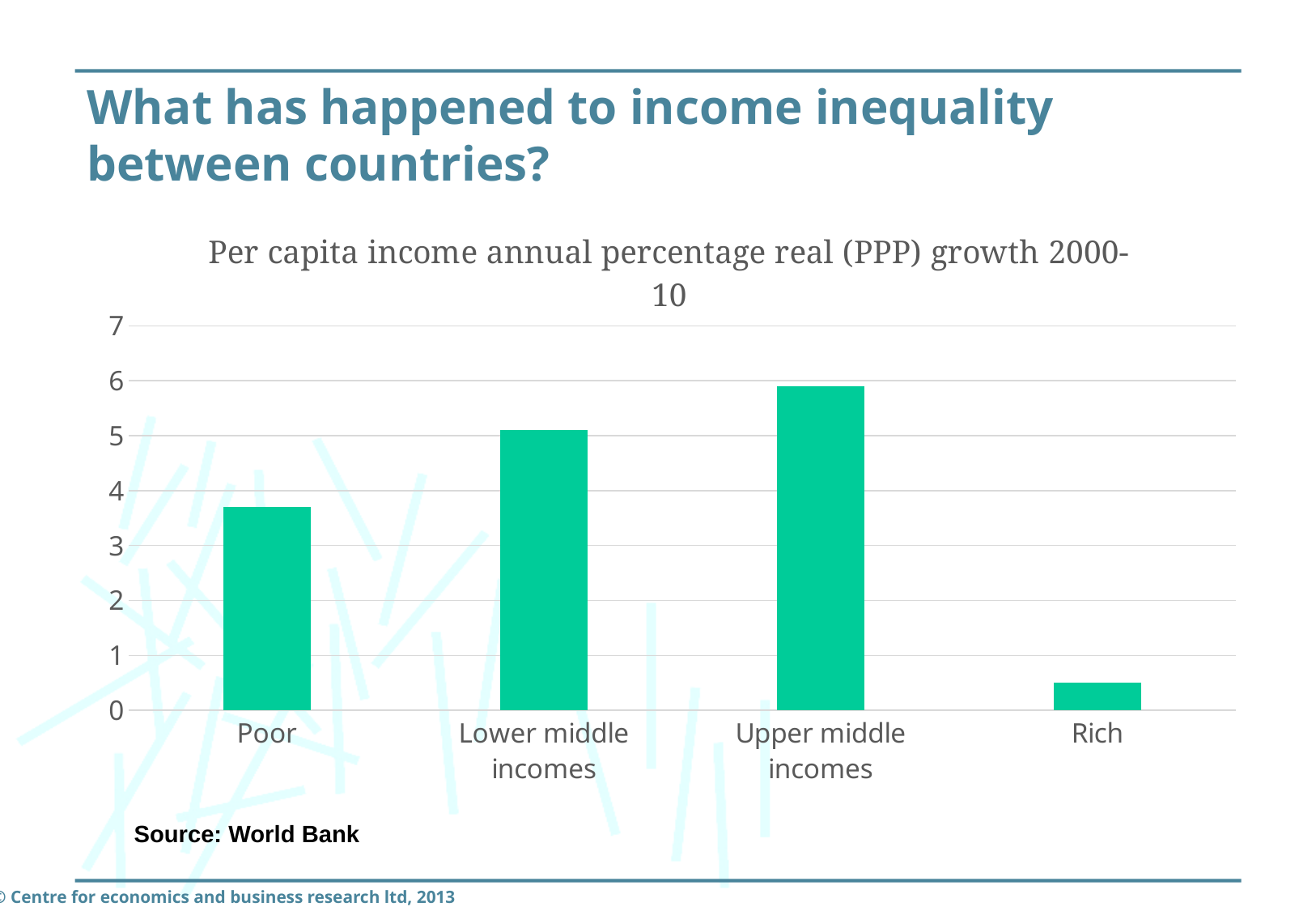
What kind of chart is shown on the slide? bar chart How many categories are shown on the x axis of the chart? 4 What source is cited for the chart data? World Bank Is the value for Rich greater or less than 1? less Which is larger, the value for Poor or the value for Lower middle incomes? Lower middle incomes Which is larger, the value for Rich or the value for Poor? Poor Which category has the highest per capita income annual percentage real (PPP) growth 2000-10? Upper middle incomes Is the value for Poor greater or less than 4? less Which category has the lowest per capita income annual percentage real (PPP) growth 2000-10? Rich What is the title of the chart? Per capita income annual percentage real (PPP) growth 2000-10